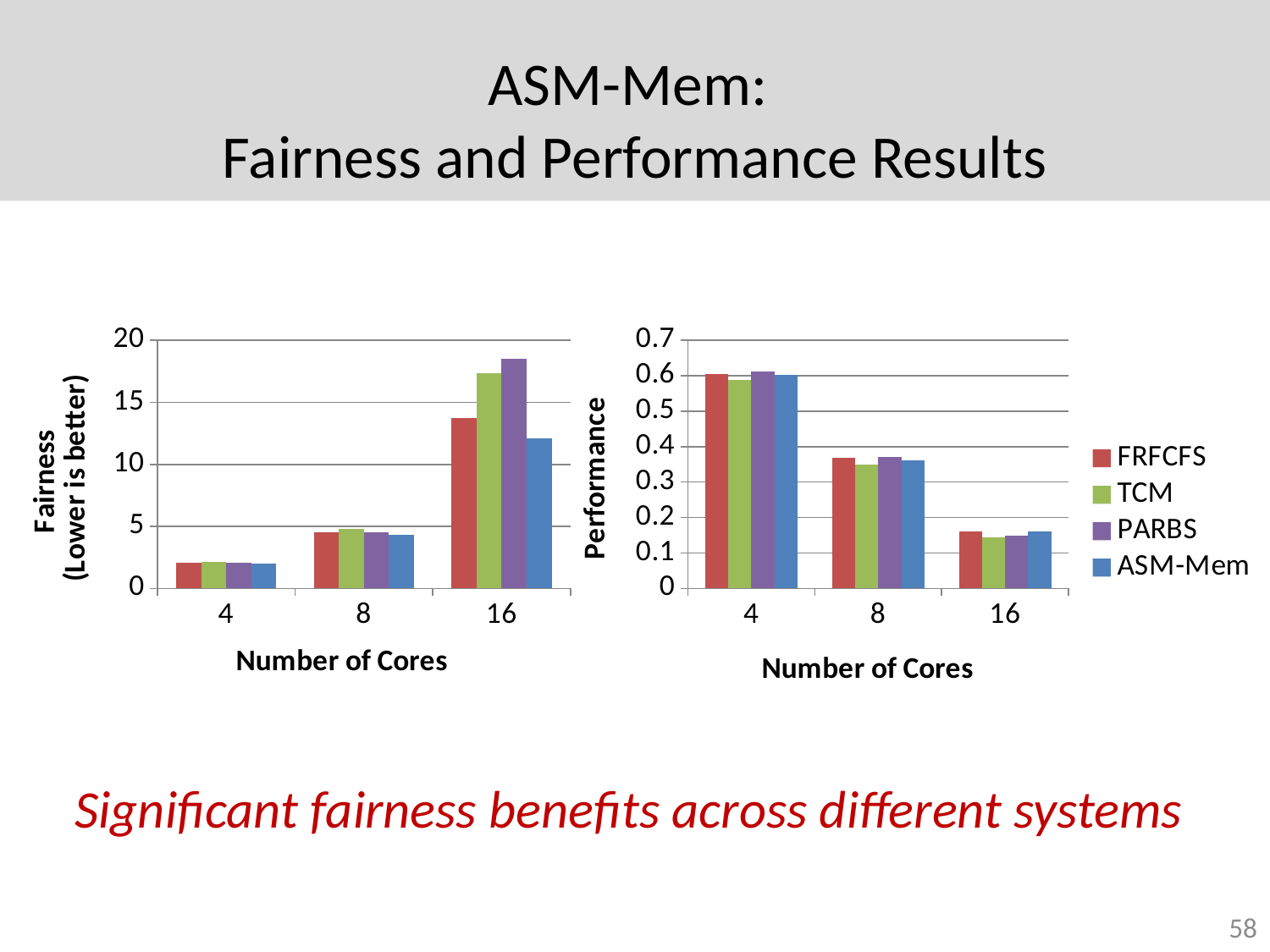
What kind of chart is the left chart (Fairness)? bar chart What is the x-axis label of the right chart (Performance)? Number of Cores In the left chart (Fairness), which series has the highest value at 16 cores? PARBS In the left chart (Fairness), do the values rise or fall as the number of cores increases? rise In the left chart (Fairness), how many core-count categories are shown on the x axis? 3 In the right chart (Performance), is the value for FRFCFS at 4 cores greater or less than 0.5? greater In the right chart (Performance), do the values rise or fall as the number of cores increases? fall In the left chart (Fairness), is the value for ASM-Mem at 16 cores greater or less than 15? less How many series does the legend list? 4 In the left chart (Fairness), is the value for PARBS at 16 cores greater or less than 15? greater In the left chart (Fairness), at 16 cores, which is larger: FRFCFS or TCM? TCM In the left chart (Fairness), which series has the lowest value at 16 cores? ASM-Mem